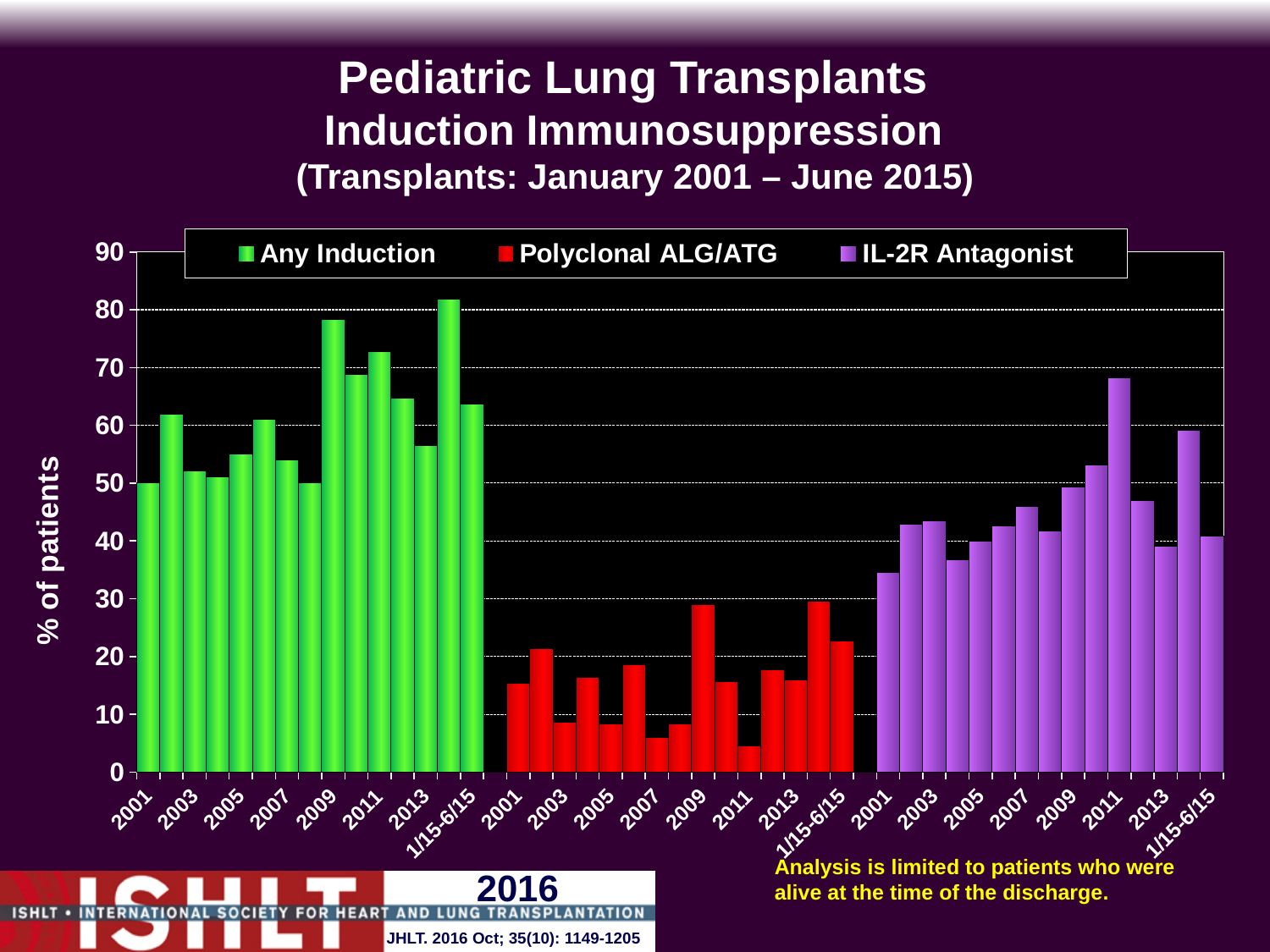
Which is larger for Any Induction: the value for 2002 or the value for 2003? 2002 In which year is the Any Induction percentage highest? 2014 In which year is the Polyclonal ALG/ATG percentage lowest? 2011 In which year is the IL-2R Antagonist percentage lowest? 2001 Is the Any Induction value for 2009 greater or less than 70? greater Is the Polyclonal ALG/ATG value for 2011 greater or less than 10? less How many series does the legend list? 3 What is the label on the y axis? % of patients What kind of chart is shown on the slide? bar chart In which year is the IL-2R Antagonist percentage highest? 2011 Is the IL-2R Antagonist value for 2011 greater or less than 60? greater How many time periods (bars) are plotted for the Any Induction series? 15